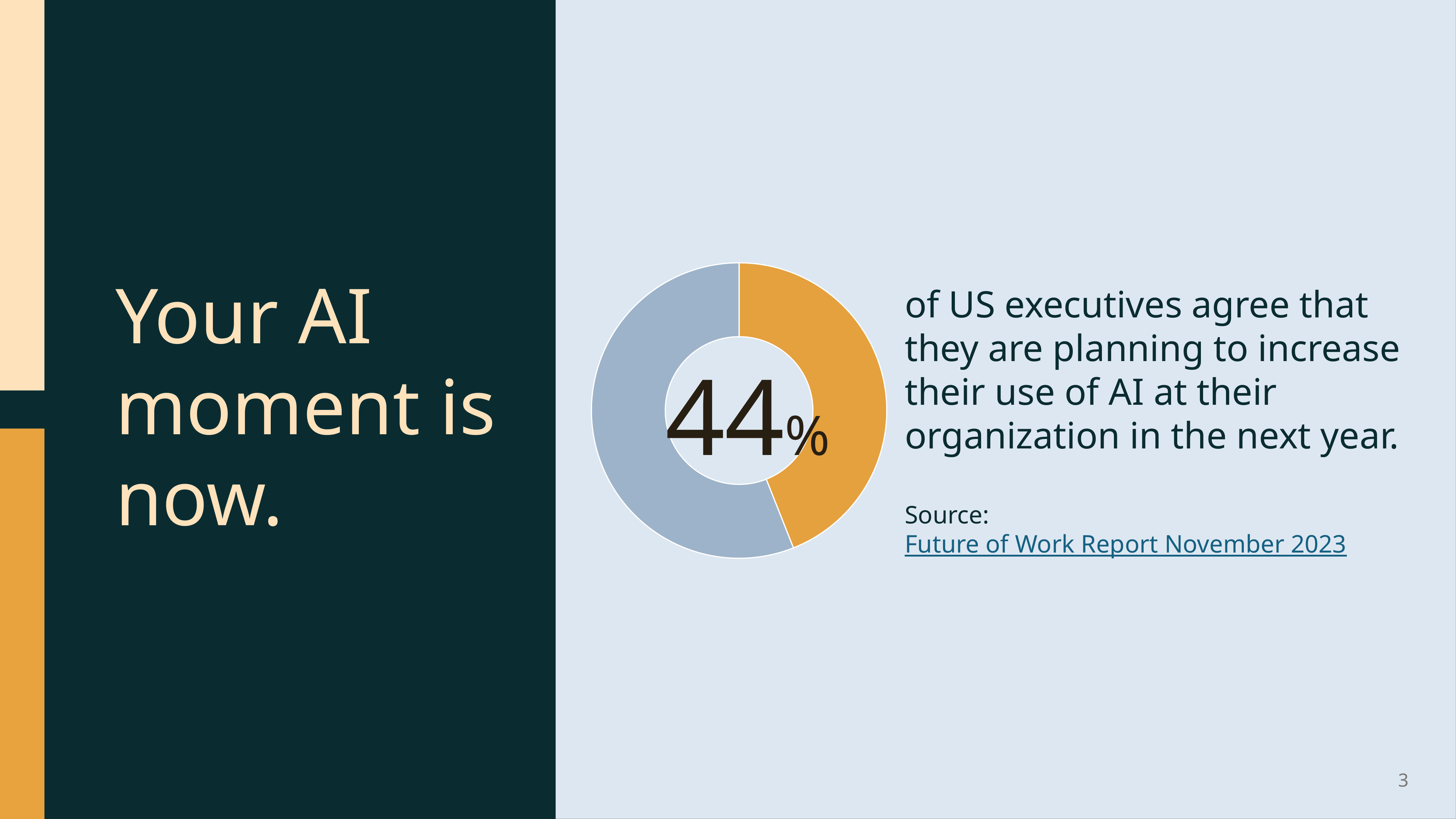
Is the orange segment of the donut chart greater or less than 50%? less What does the 44% in the donut chart represent? US executives planning to increase their use of AI at their organization in the next year How many segments does the donut chart have? 2 What kind of chart is shown on the slide? donut chart Which segment of the donut chart is larger, the orange one or the grey-blue one? grey-blue What share of the donut chart does the orange segment represent? 44% What percentage is printed in the centre of the donut chart? 44% What share of the donut chart does the grey-blue segment represent? 56% What source is cited for the donut chart's data? Future of Work Report November 2023